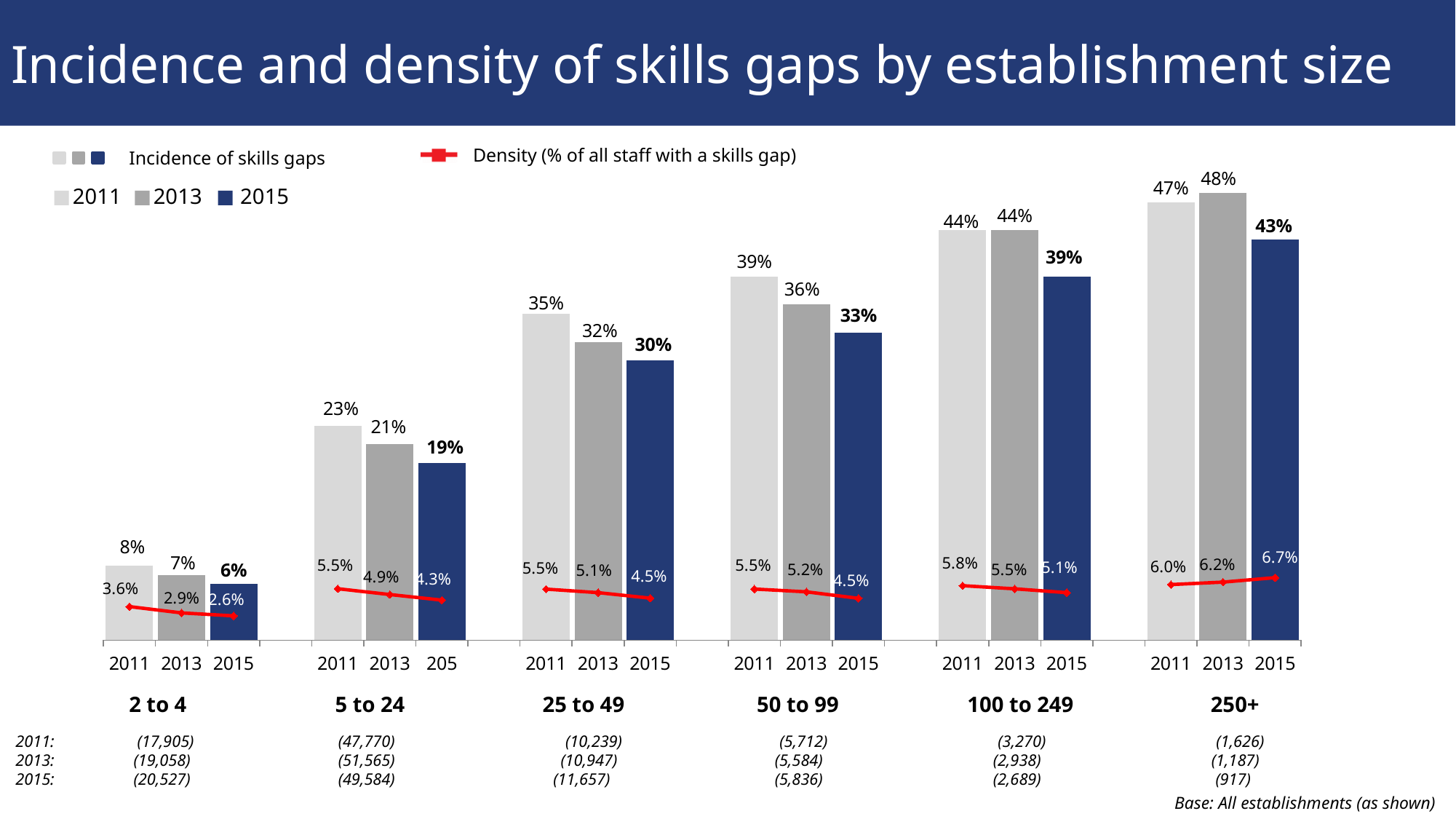
How many years does the legend list for incidence of skills gaps? 3 What is the incidence of skills gaps in 2015 for establishments with 250+ staff? 43% What is the density of skills gaps in 2013 for establishments with 5 to 24 staff? 4.9% How many establishment size bands are shown on the chart? 6 Does the density of skills gaps for establishments with 250+ staff rise or fall from 2011 to 2015? Rise Which is larger: the 2013 incidence of skills gaps for 100 to 249 staff or for 250+ staff? 250+ Which establishment size band has the lowest density of skills gaps in 2015? 2 to 4 Which establishment size band has the highest incidence of skills gaps in 2015? 250+ What colour is the line showing density (% of all staff with a skills gap)? Red What kind of chart is used to show the incidence of skills gaps? Bar chart What is the difference between the 2011 and 2015 incidence of skills gaps for establishments with 50 to 99 staff? 6 percentage points What is the incidence of skills gaps in 2011 for establishments with 25 to 49 staff? 35%